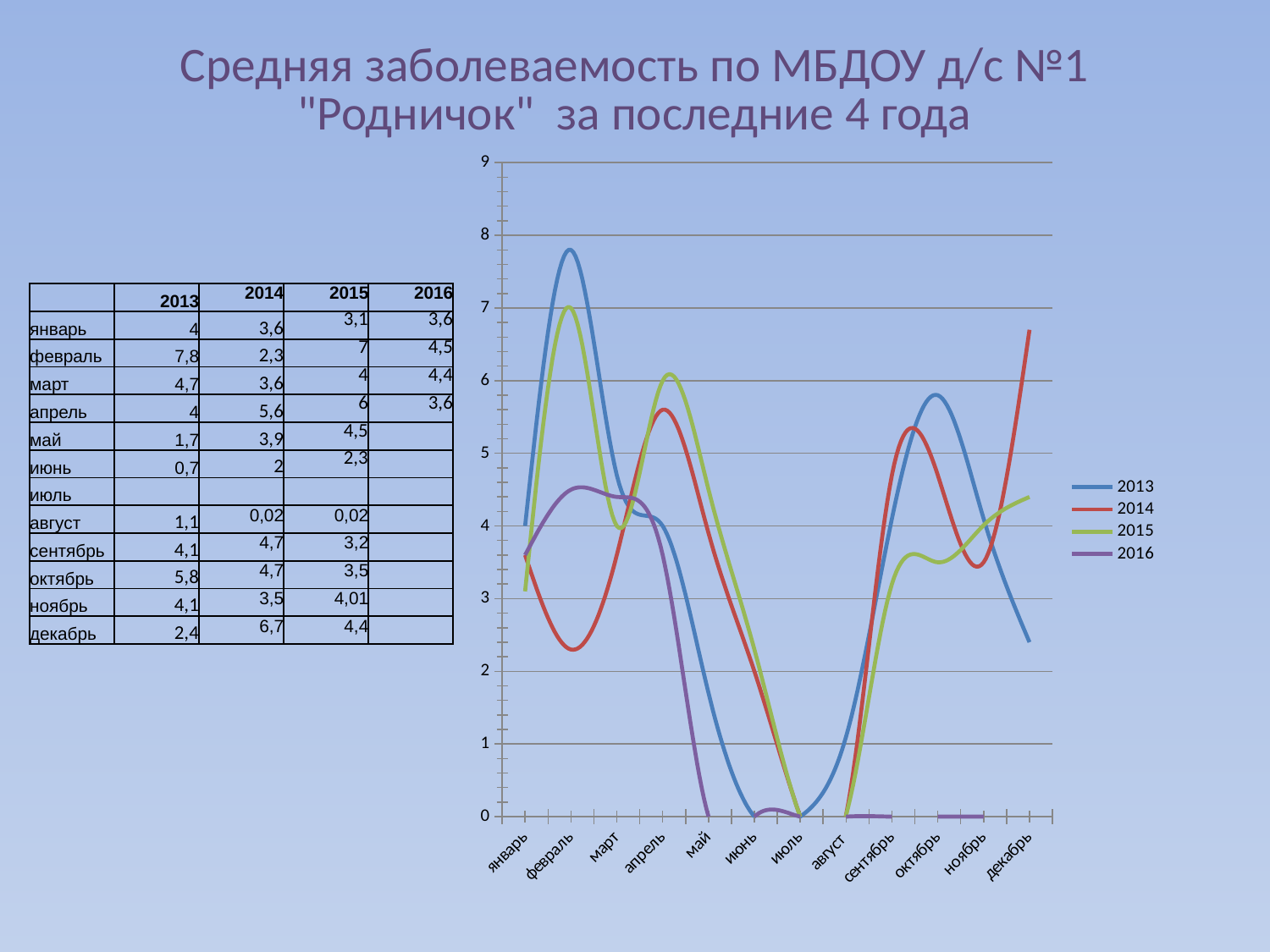
Is the value for 2013 in февраль greater or less than 7? greater How many months are shown along the x axis? 12 What kind of chart is shown on the slide? line chart In which month does the 2013 series reach its highest value? февраль How many series does the legend list? 4 What is the value for 2013 in февраль? 7,8 In which month does the 2014 series reach its highest value? декабрь Which is larger in октябрь, the value for 2013 or for 2015? 2013 What is the difference between the 2013 and 2014 values in февраль? 5,5 What is the value for 2016 in февраль? 4,5 What is the value for 2014 in декабрь? 6,7 Does the 2013 series rise or fall from февраль to июнь? fall